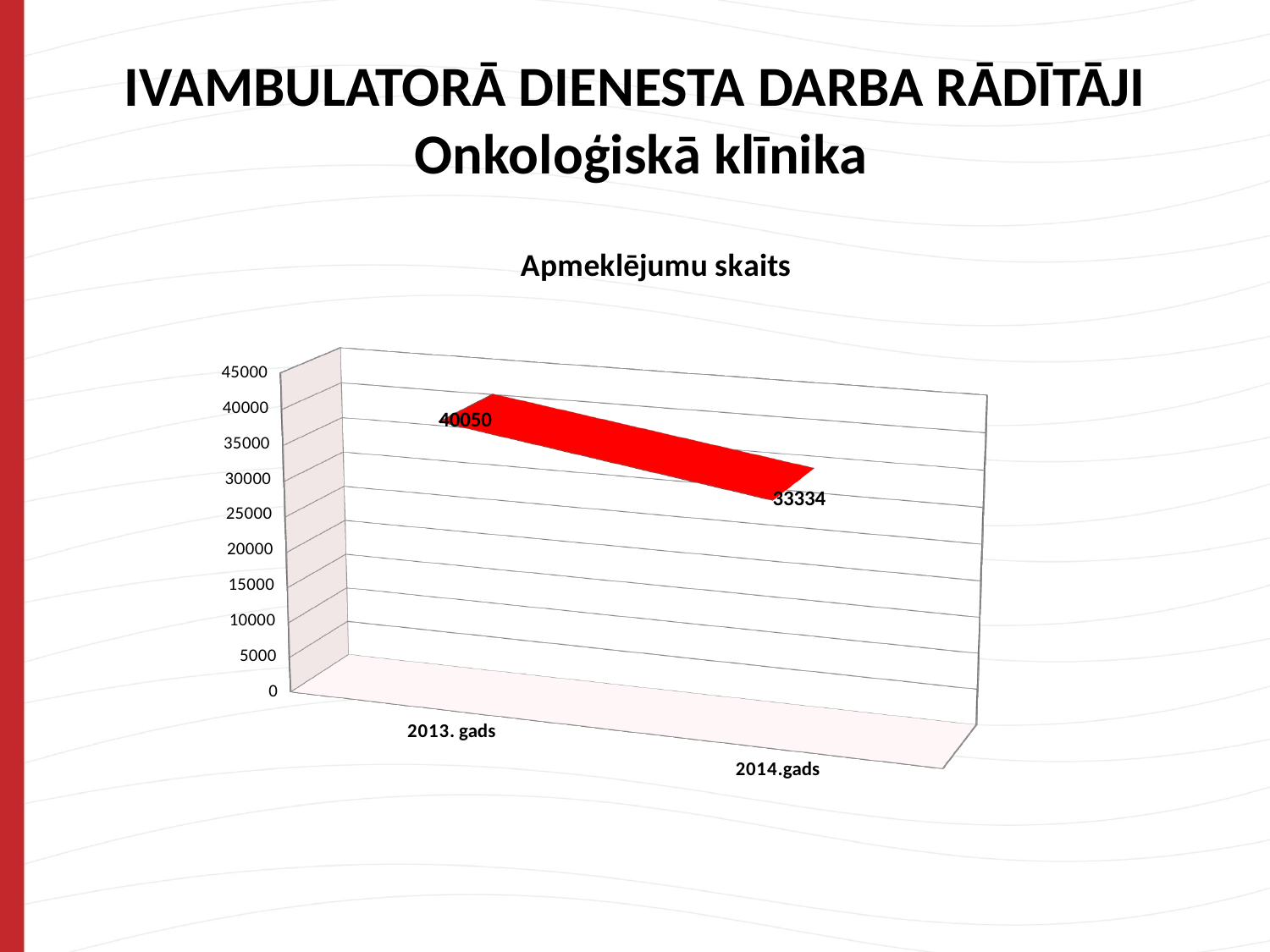
What is the title of the chart? Apmeklējumu skaits Which year has the highest value in the Apmeklējumu skaits chart? 2013. gads What is the value for 2013. gads in the Apmeklējumu skaits chart? 40050 Is the value for 2013. gads greater or less than 35000? greater Which is larger, the value for 2013. gads or for 2014.gads? 2013. gads Which year has the lowest value in the Apmeklējumu skaits chart? 2014.gads Do the values rise or fall from 2013. gads to 2014.gads? fall What is the value for 2014.gads in the Apmeklējumu skaits chart? 33334 What is the difference between the values for 2013. gads and 2014.gads? 6716 What is the maximum value shown on the vertical axis of the chart? 45000 How many categories are shown on the x axis of the chart? 2 Is the value for 2014.gads greater or less than 35000? less